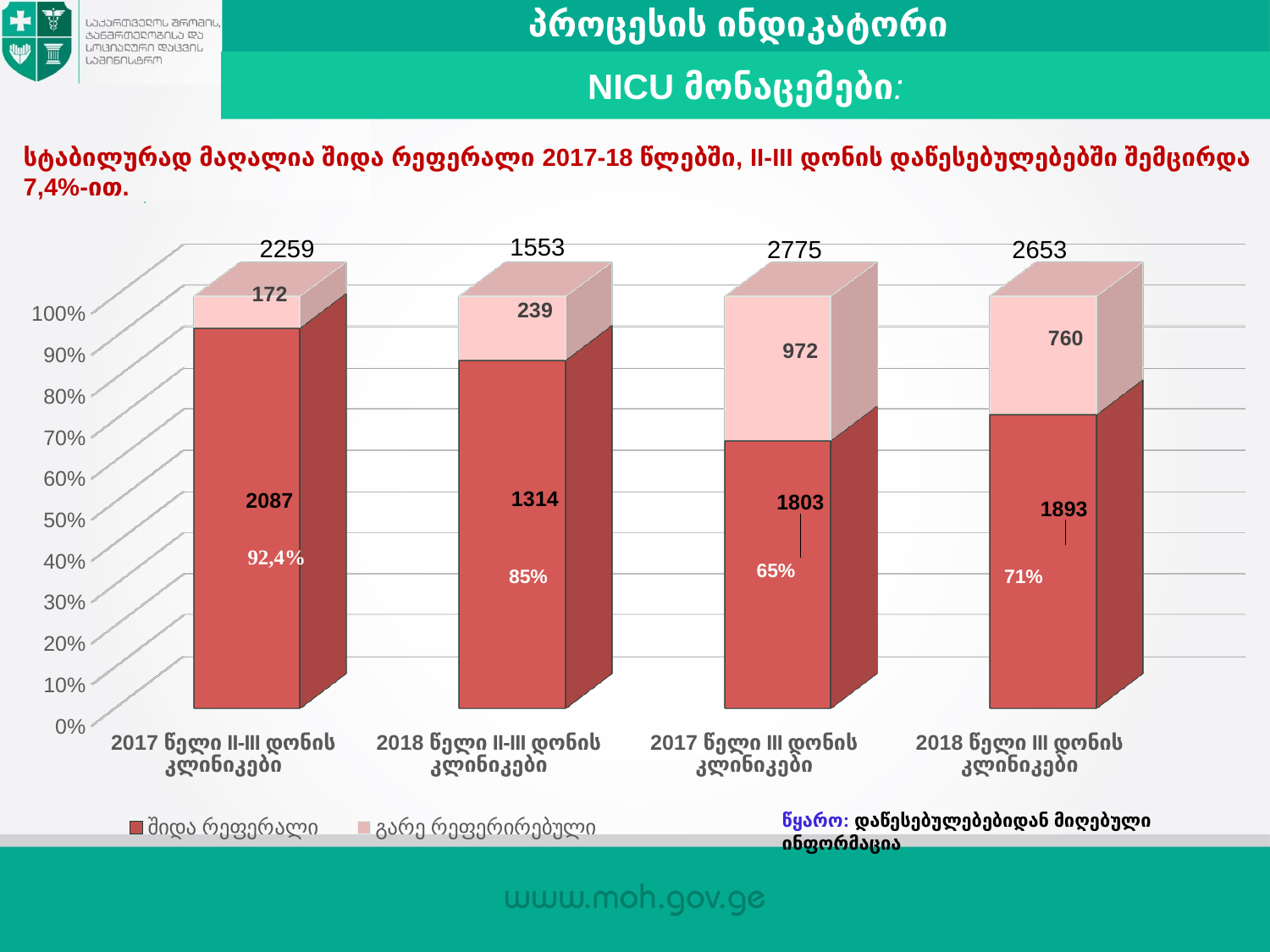
How many categories are shown on the x axis? 4 Which category has the highest გარე რეფერირებული value? 2017 წელი III დონის კლინიკები What percentage is shown inside the შიდა რეფერალი segment for 2017 წელი II-III დონის კლინიკები? 92,4% What is the difference between the შიდა რეფერალი values for 2018 წელი III დონის კლინიკები and 2017 წელი III დონის კლინიკები? 90 How many series does the legend list? 2 Which is larger: the გარე რეფერირებული value for 2017 წელი II-III დონის კლინიკები or for 2018 წელი II-III დონის კლინიკები? 2018 წელი II-III დონის კლინიკები What kind of chart is shown on the slide? Stacked bar chart What is the value of გარე რეფერირებული for 2018 წელი III დონის კლინიკები? 760 What total is printed above the bar for 2017 წელი III დონის კლინიკები? 2775 Which category has the lowest შიდა რეფერალი value? 2018 წელი II-III დონის კლინიკები What is the value of შიდა რეფერალი for 2017 წელი II-III დონის კლინიკები? 2087 What is the value of გარე რეფერირებული for 2018 წელი II-III დონის კლინიკები? 239